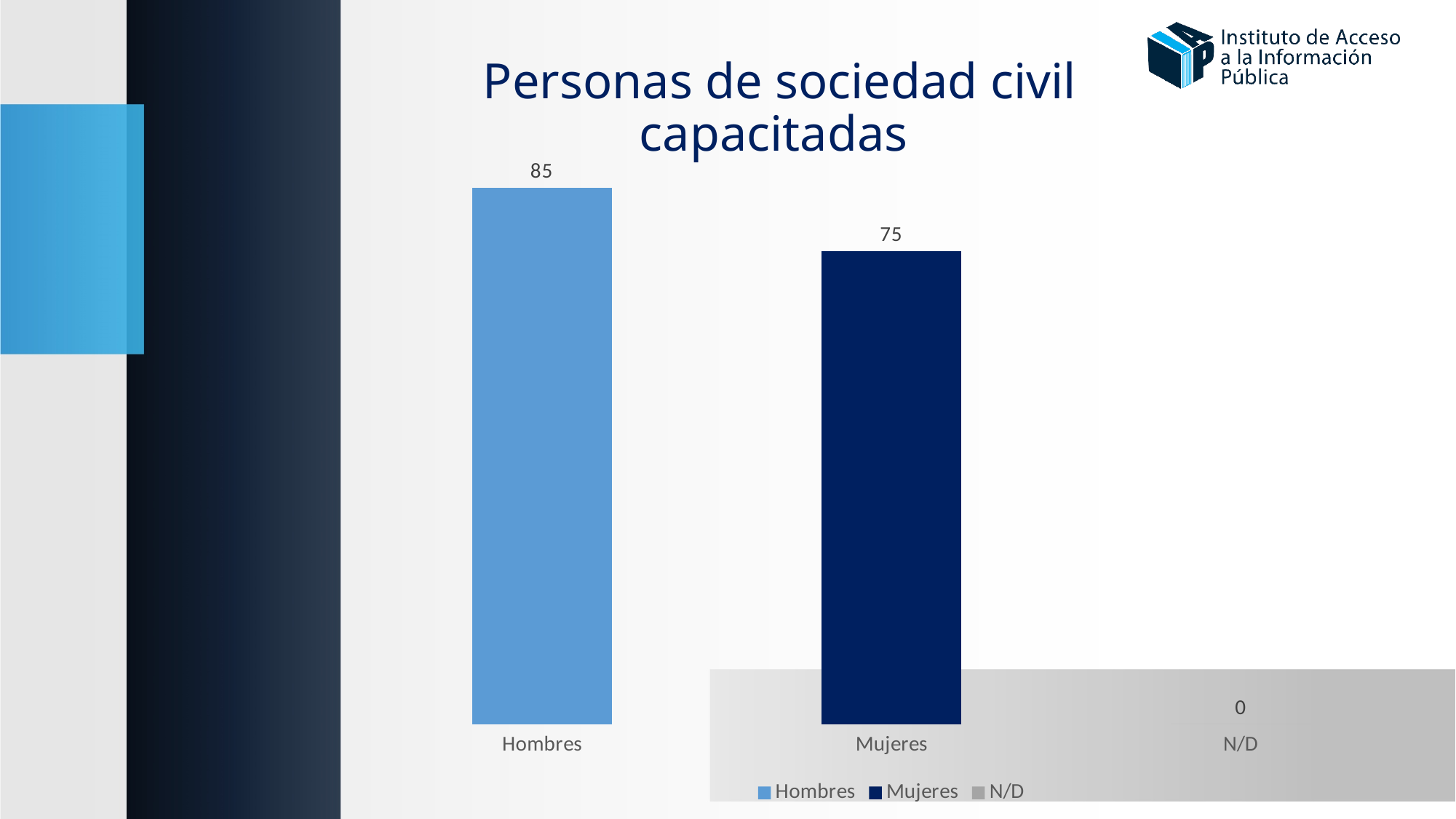
What is the value for Hombres? 85 What is the title of the chart? Personas de sociedad civil capacitadas What is the value for N/D? 0 Which is larger, the value for Hombres or the value for Mujeres? Hombres What is the total of the values for Hombres, Mujeres and N/D? 160 What is the difference between the values for Hombres and Mujeres? 10 Which category has the highest value? Hombres Which category has the lowest value? N/D What is the value for Mujeres? 75 How many categories are shown on the x axis? 3 What kind of chart is shown on the slide? Bar chart How many entries does the legend list? 3